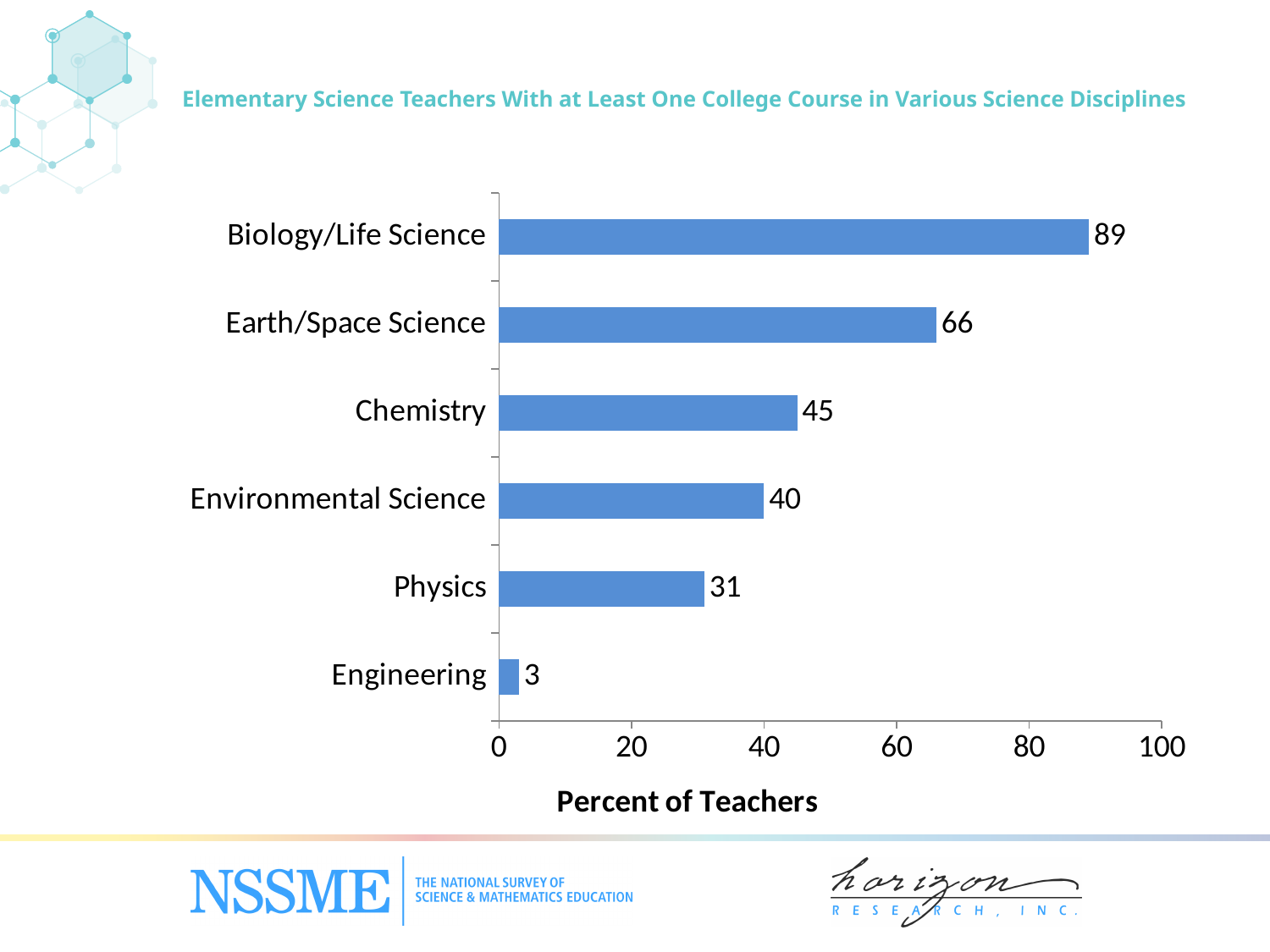
Is the value for Physics greater or less than 40? less Which discipline has the highest percent of teachers? Biology/Life Science What is the value shown for Earth/Space Science? 66 Which discipline has the lowest percent of teachers? Engineering Which has a larger value, Earth/Space Science or Chemistry? Earth/Space Science What is the difference between the values for Chemistry and Environmental Science? 5 What is the value shown for Physics? 31 What kind of chart is shown on the slide? bar chart What is the difference between the values for Biology/Life Science and Engineering? 86 What is the label of the horizontal axis? Percent of Teachers What percent of elementary science teachers have at least one college course in Biology/Life Science? 89 How many disciplines are shown in the chart? 6